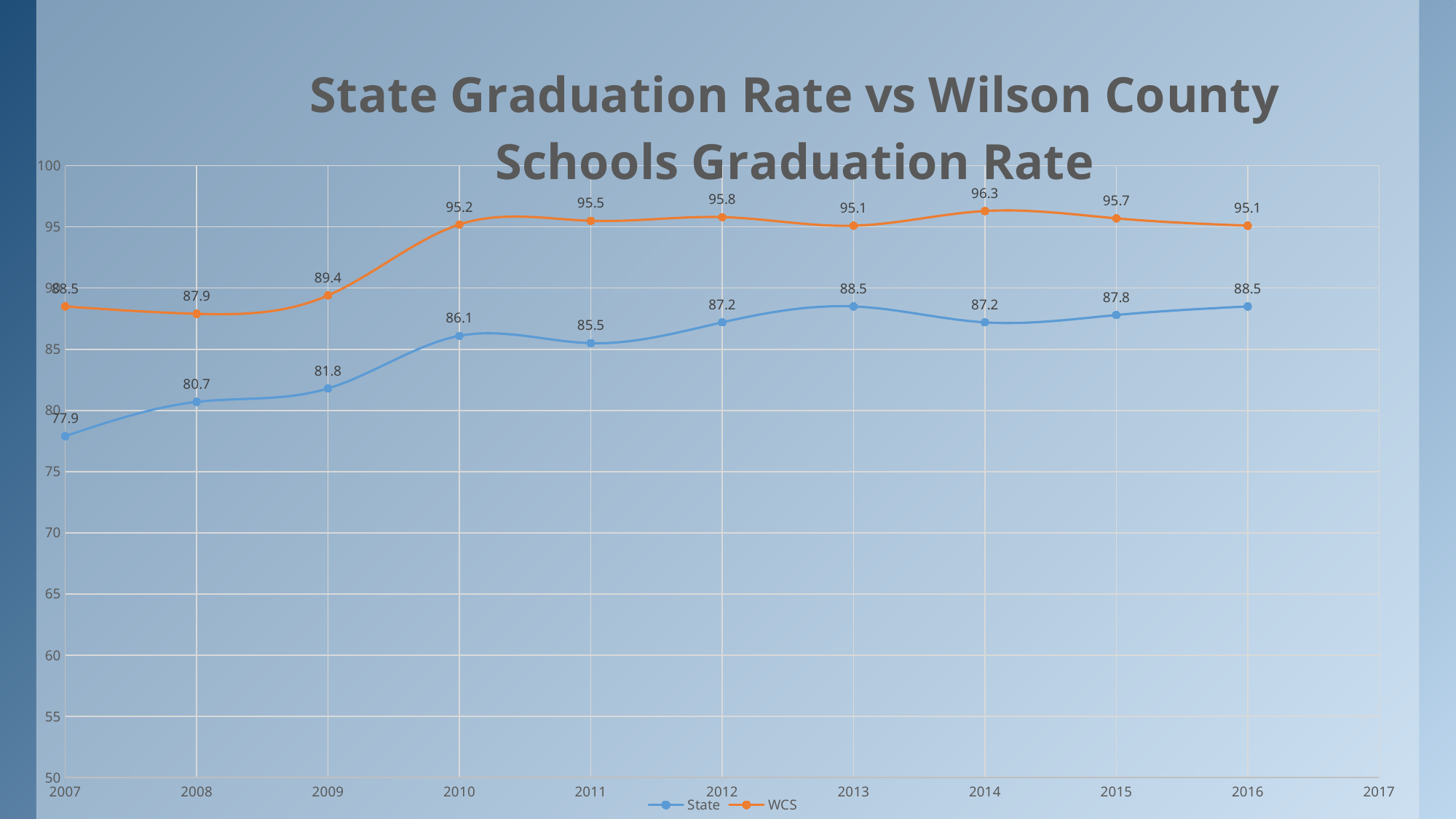
Does the State graduation rate generally rise or fall from 2007 to 2016? rise What is the difference between the WCS and State graduation rates in 2016? 6.6 Which series has the higher graduation rate in 2009, State or WCS? WCS In which year is the WCS graduation rate lowest? 2008 What is the WCS graduation rate in 2012? 95.8 In which year is the WCS graduation rate highest? 2014 How many series does the legend list? 2 In which year is the State graduation rate lowest? 2007 What is the State graduation rate in 2010? 86.1 What type of chart is shown on the slide? line chart What is the title of the chart? State Graduation Rate vs Wilson County Schools Graduation Rate What is the State graduation rate in 2007? 77.9